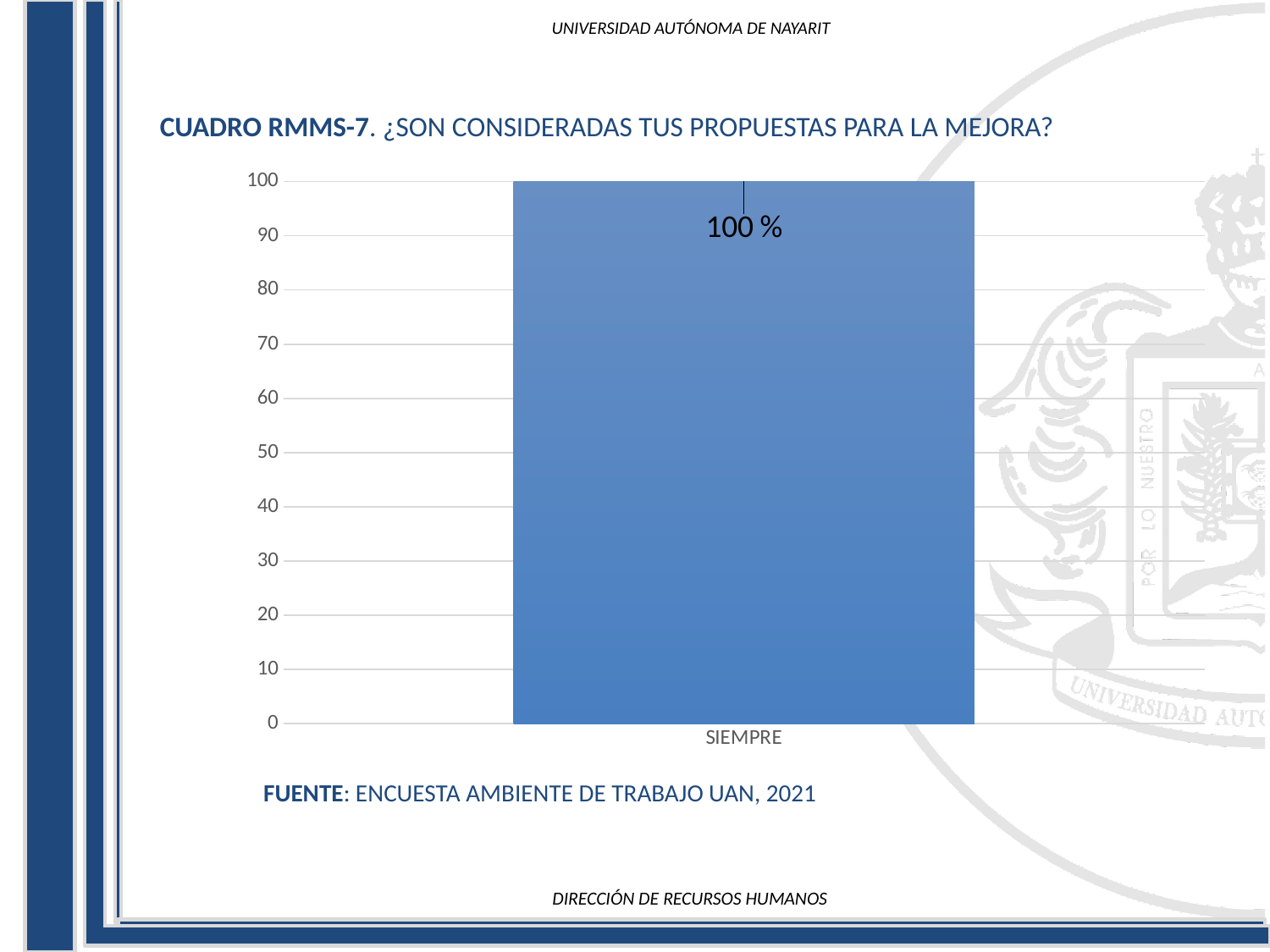
What kind of chart is shown on the slide? bar chart What is the maximum value shown on the vertical axis? 100 How many categories are plotted on the chart? 1 Is the value for SIEMPRE greater or less than 50? greater Which category has the highest value on the chart? SIEMPRE What is the value shown for the SIEMPRE category? 100 % What is the label of the only category on the x axis? SIEMPRE